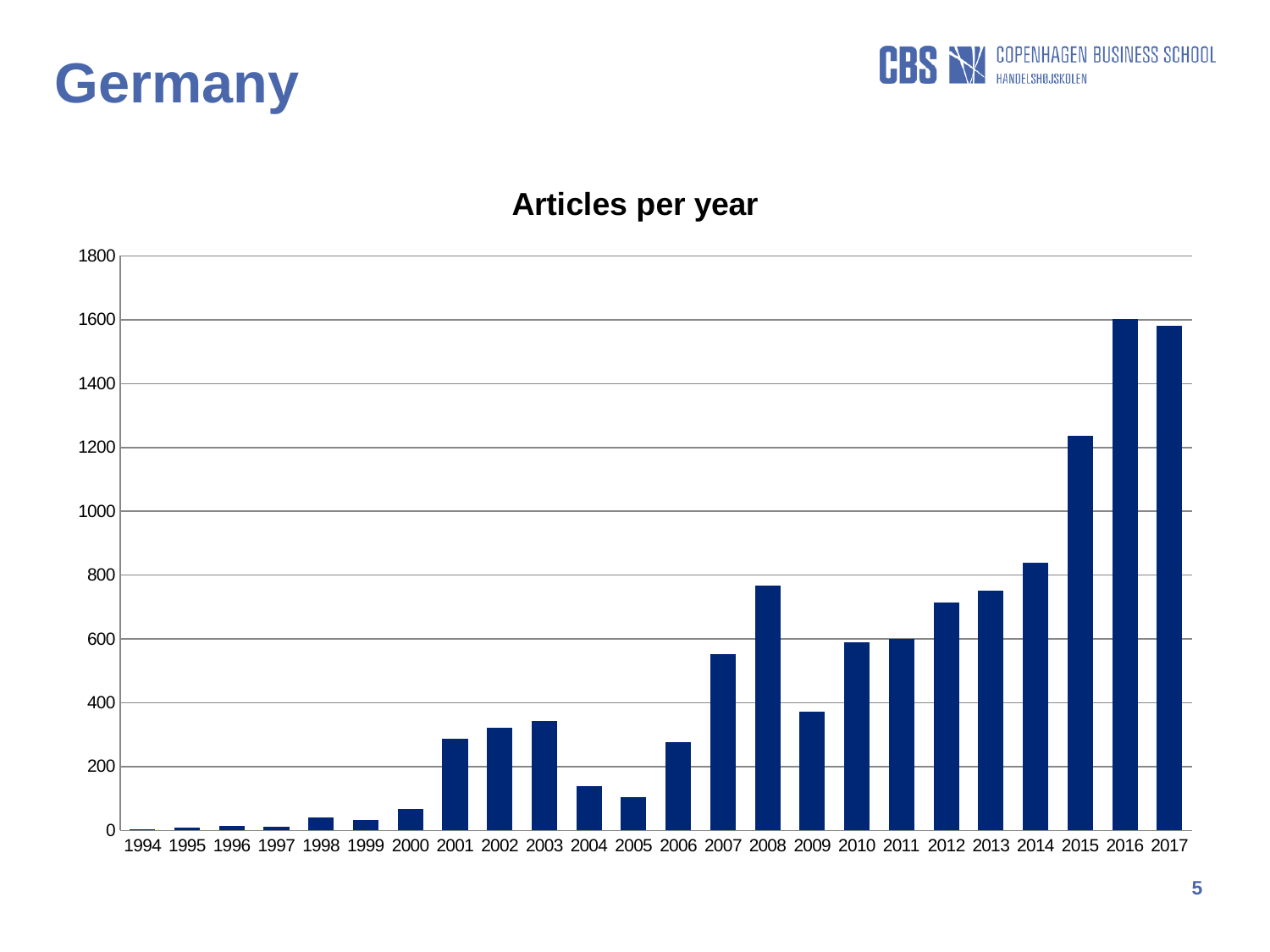
Overall, do the values rise or fall from 1994 to 2017? rise Is the value for 2004 greater or less than 200? less Is the value for 2015 greater or less than 1200? greater How many years are shown on the x axis of the chart? 24 What kind of chart is shown on the slide? bar chart Which year has the larger value, 2008 or 2009? 2008 What is the title of the chart? Articles per year Is the value for 2001 greater or less than 200? greater Which year has the larger value, 2003 or 2004? 2003 Which year has the larger value, 2014 or 2015? 2015